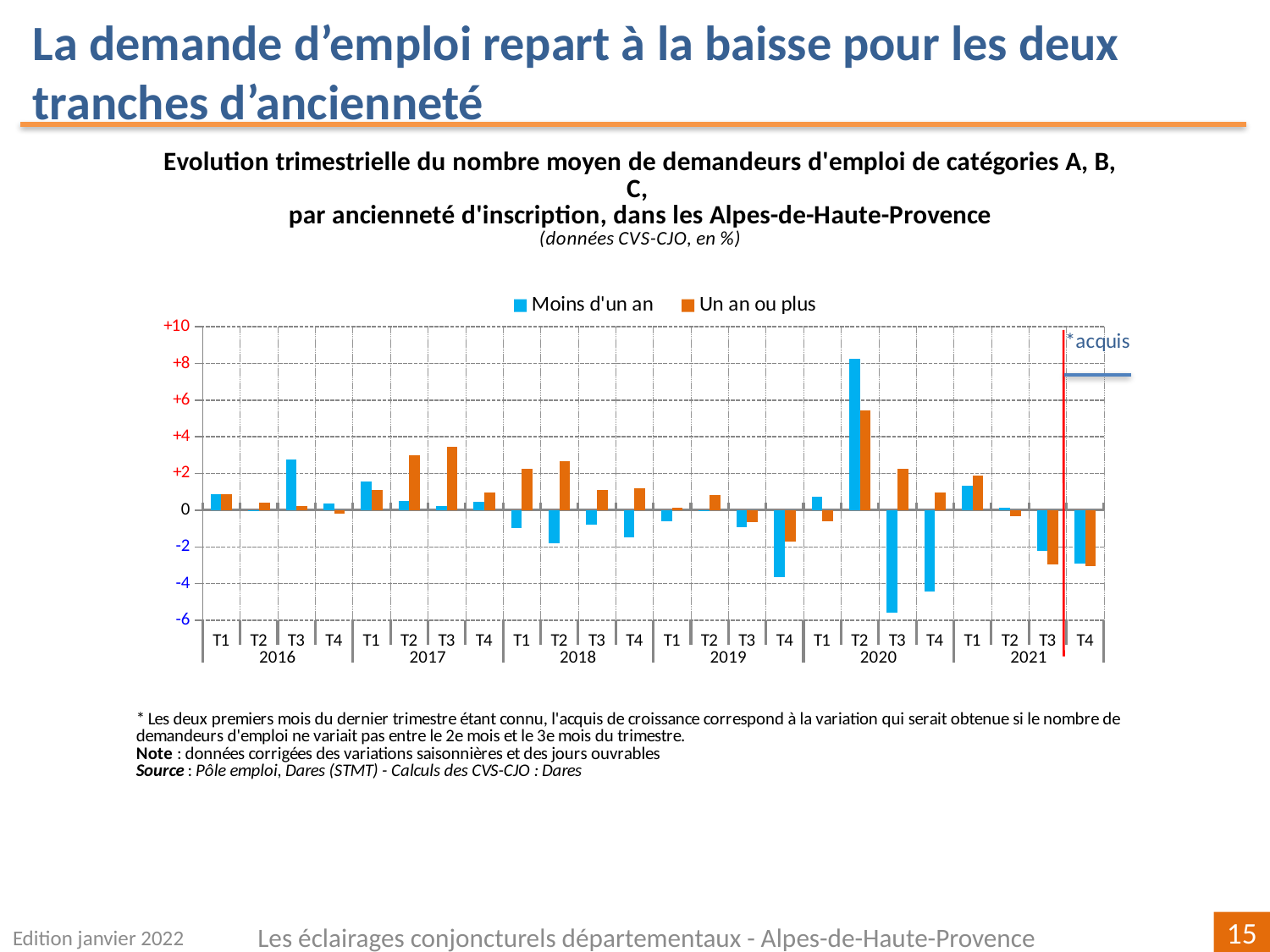
In which quarter does the 'Moins d'un an' series reach its highest value? T2 2020 Is the value for 'Moins d'un an' in T3 2020 greater or less than -4? less In which quarter does the 'Moins d'un an' series reach its lowest value? T3 2020 What are the two series named in the legend? Moins d'un an; Un an ou plus How many quarters are plotted along the x axis? 24 What kind of chart is shown on the slide? bar chart Is the value for 'Moins d'un an' in T2 2020 greater or less than +6? greater Which quarter is marked by the red vertical line labelled '*acquis'? T4 2021 In which quarter does the 'Un an ou plus' series reach its highest value? T2 2020 In T3 2020, which series has the larger value, 'Moins d'un an' or 'Un an ou plus'? Un an ou plus How many series does the legend list? 2 Is the value for 'Un an ou plus' in T3 2017 greater or less than +2? greater